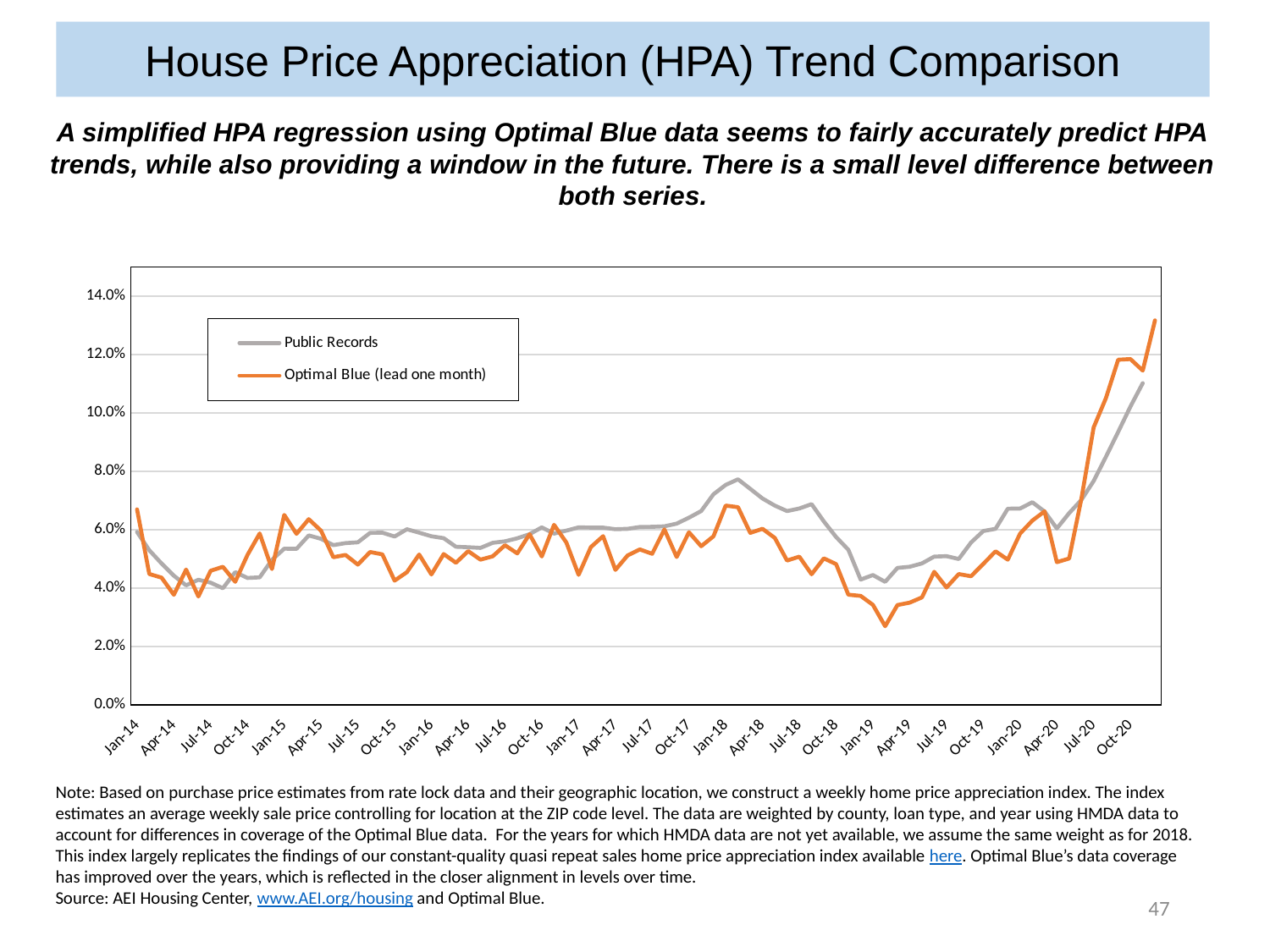
Is the Public Records value at its early-2018 peak greater or less than 6.0%? greater How many series does the legend list? 2 Is the lowest value of the Optimal Blue (lead one month) series, reached in early 2019, greater or less than 4.0%? less What is the highest value shown on the vertical axis? 14.0% What kind of chart is shown on the slide? Line chart Do both series rise or fall between Jul-20 and the end of the chart? Rise At the end of the chart (late 2020), which series is higher: Public Records or Optimal Blue (lead one month)? Optimal Blue (lead one month) Which colour is used for the Optimal Blue (lead one month) line? Orange Is the value of the Optimal Blue (lead one month) series at the end of the chart (late 2020) greater or less than 12.0%? greater What are the two series named in the legend? Public Records; Optimal Blue (lead one month) How many date labels are shown along the x axis? 28